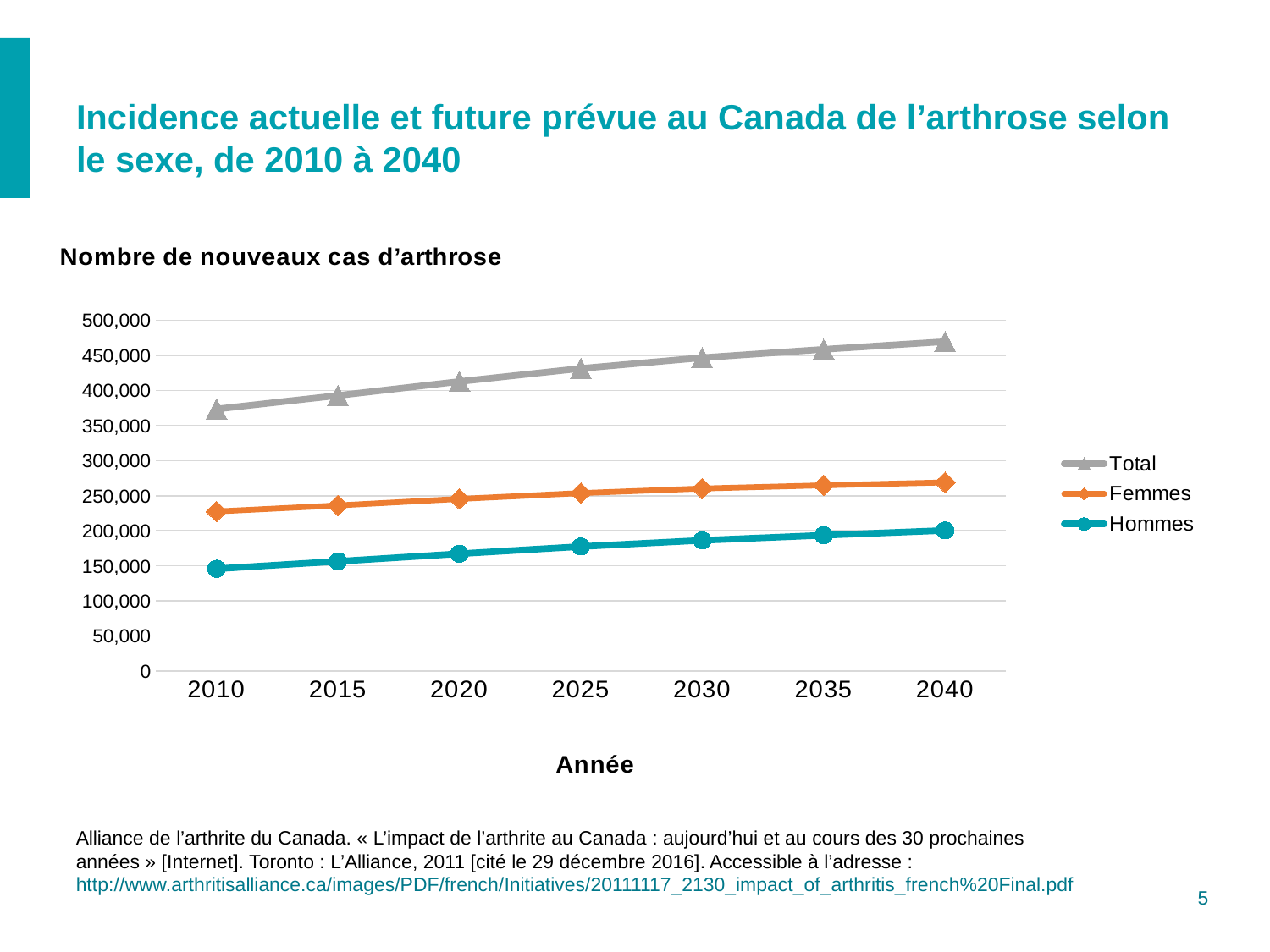
Is the value for Hommes in 2010 greater or less than 200,000? less Does the Total series rise or fall from 2010 to 2040? rise How many series does the legend list? 3 What is the title of the x axis? Année In which year is the Hommes series at its lowest? 2010 How many years are plotted along the x axis? 7 What kind of chart is shown on the slide? line chart Is the value for Total in 2010 greater or less than 350,000? greater Is the value for Total in 2040 greater or less than 500,000? less In which year is the Total series at its highest? 2040 In 2020, which series has the larger value, Femmes or Hommes? Femmes